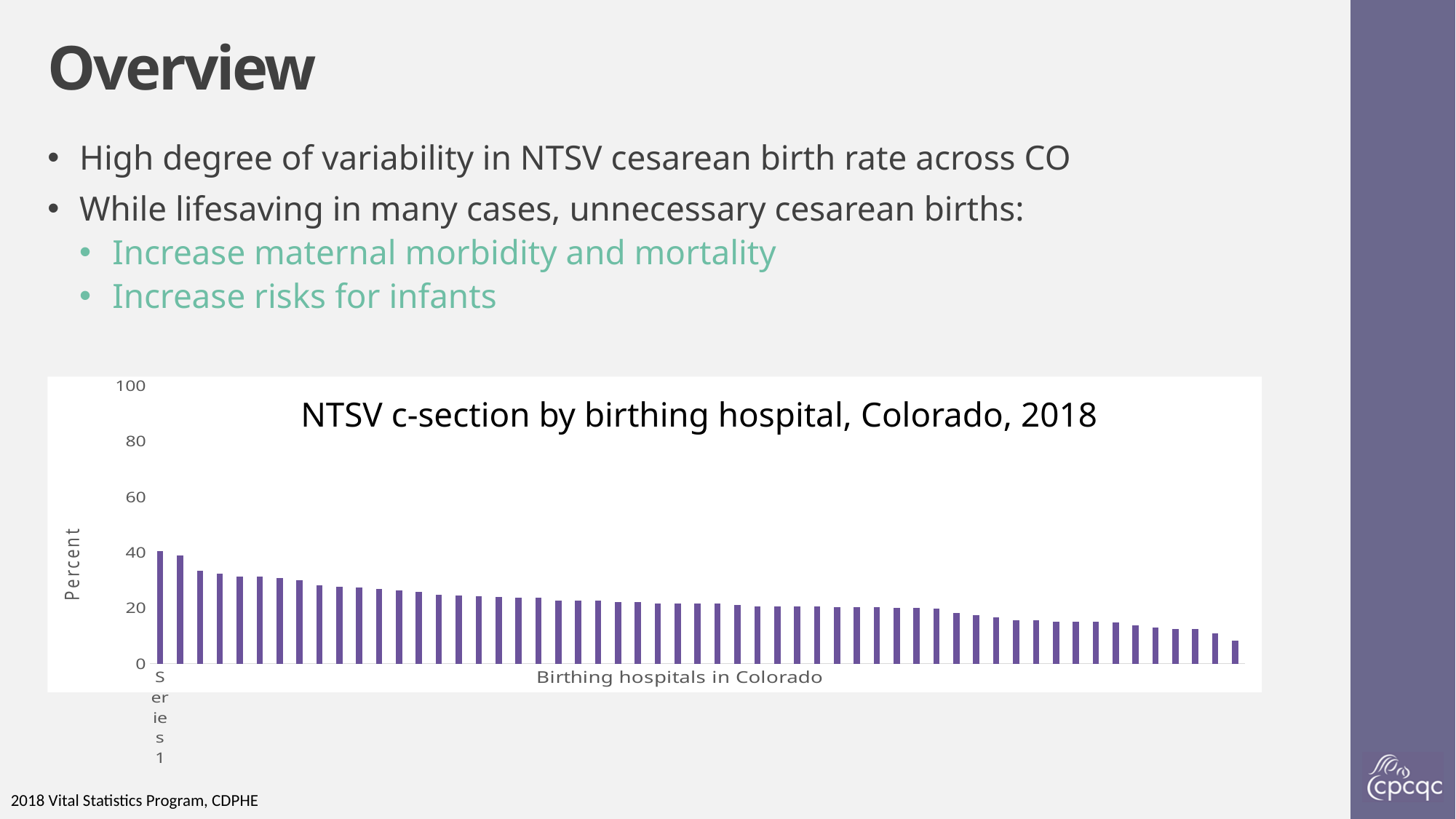
Which bar is larger, the leftmost bar or the rightmost bar? The leftmost bar Is the value for the leftmost bar greater or less than 20? greater What kind of chart is shown on the slide? Bar chart Is the value for the rightmost bar greater or less than 20? less What is the label on the vertical axis of the chart? Percent What is the title of the chart? NTSV c-section by birthing hospital, Colorado, 2018 Is any bar in the chart greater than 60? No Do the bar values rise or fall moving from left to right along the x axis? Fall Where is the shortest bar located on the chart, at the left end or the right end? The right end Where is the tallest bar located on the chart, at the left end or the right end? The left end